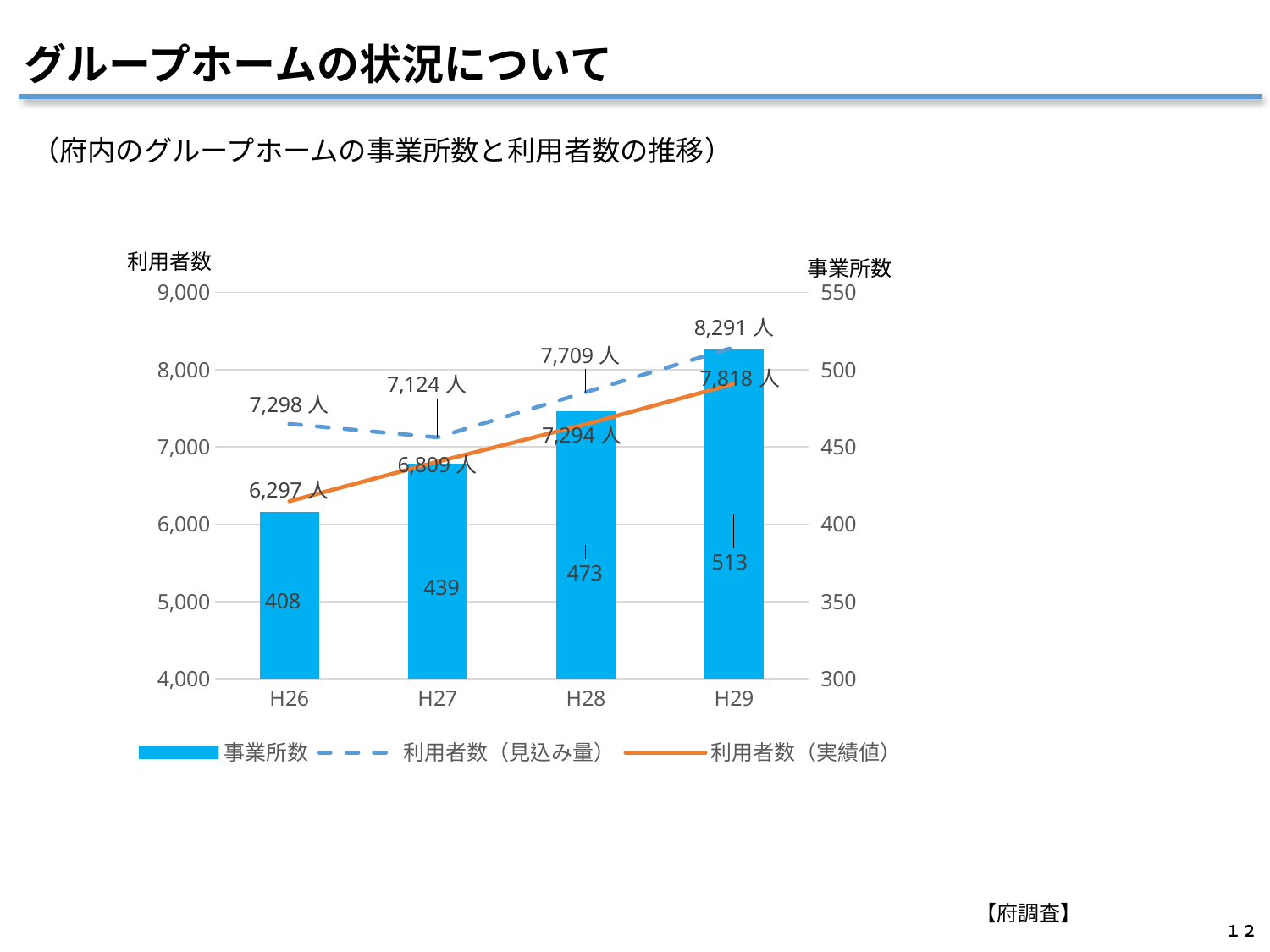
Which series is drawn as a dashed line? 利用者数（見込み量） What is the value of 事業所数 for H26? 408 Does 利用者数（実績値） rise or fall from H26 to H29? rise What is the value of 利用者数（実績値） for H29? 7,818 人 What is the difference in 事業所数 between H29 and H26? 105 How many years are shown on the x axis? 4 What is the value of 利用者数（見込み量） for H27? 7,124 人 In H26, which is larger: 利用者数（見込み量） or 利用者数（実績値）? 利用者数（見込み量） How many series does the legend list? 3 Which year has the lowest 利用者数（見込み量）? H27 What is the difference between 利用者数（見込み量） and 利用者数（実績値） in H28? 415 人 Which year has the highest 事業所数? H29